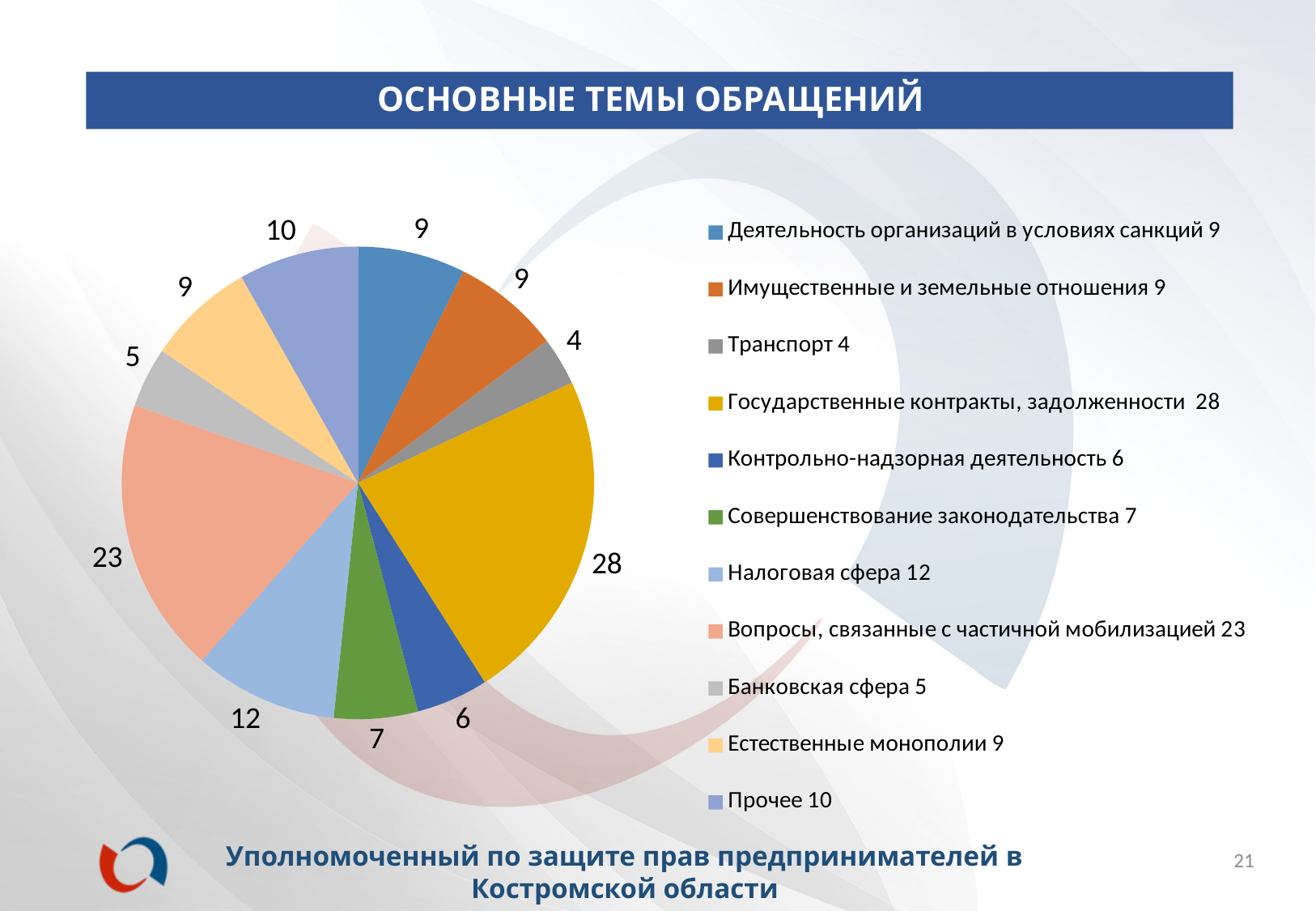
Which category has the largest slice of the pie? Государственные контракты, задолженности How many categories does the pie chart have? 11 What is the value for "Государственные контракты, задолженности"? 28 Which category has the smallest slice of the pie? Транспорт Which is larger: "Налоговая сфера" or "Прочее"? Налоговая сфера What is the value for "Транспорт"? 4 How many entries does the legend list? 11 What is the difference between the values for "Государственные контракты, задолженности" and "Вопросы, связанные с частичной мобилизацией"? 5 What is the value for "Налоговая сфера"? 12 What type of chart is shown on the slide? pie chart What is the title of the slide above the chart? ОСНОВНЫЕ ТЕМЫ ОБРАЩЕНИЙ What is the value for "Вопросы, связанные с частичной мобилизацией"? 23